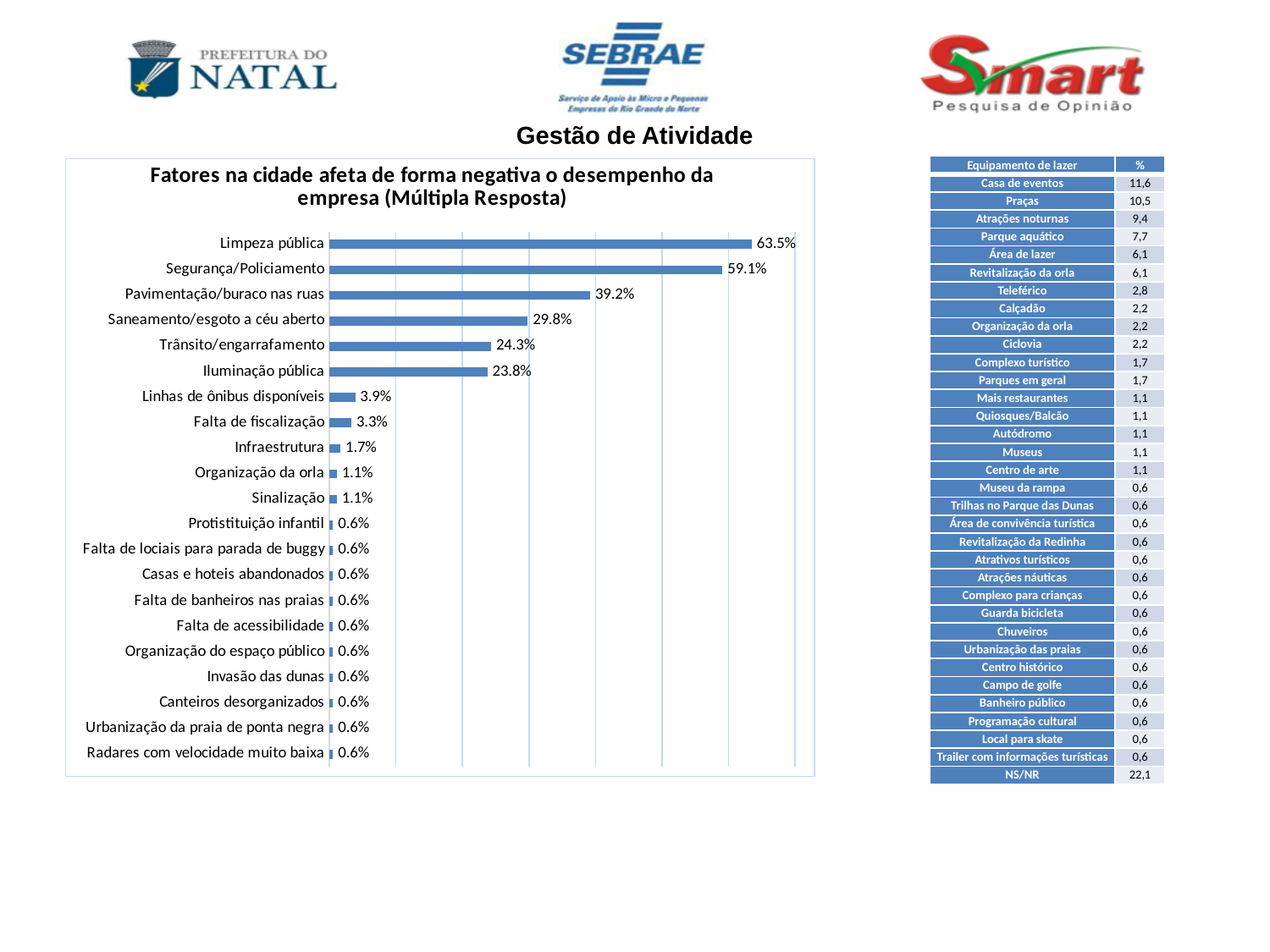
What is the difference between Limpeza pública and Segurança/Policiamento? 4.4% Which is larger, Linhas de ônibus disponíveis or Falta de fiscalização? Linhas de ônibus disponíveis What is the difference between Saneamento/esgoto a céu aberto and Trânsito/engarrafamento? 5.5% What is the value for Iluminação pública? 23.8% What is the value for Segurança/Policiamento? 59.1% What is the value for Limpeza pública? 63.5% What is the title of the chart? Fatores na cidade afeta de forma negativa o desempenho da empresa (Múltipla Resposta) Which category has the highest value? Limpeza pública What kind of chart is shown? Bar chart What is the value for Infraestrutura? 1.7% What is the value for Pavimentação/buraco nas ruas? 39.2% How many categories are shown in the chart? 21